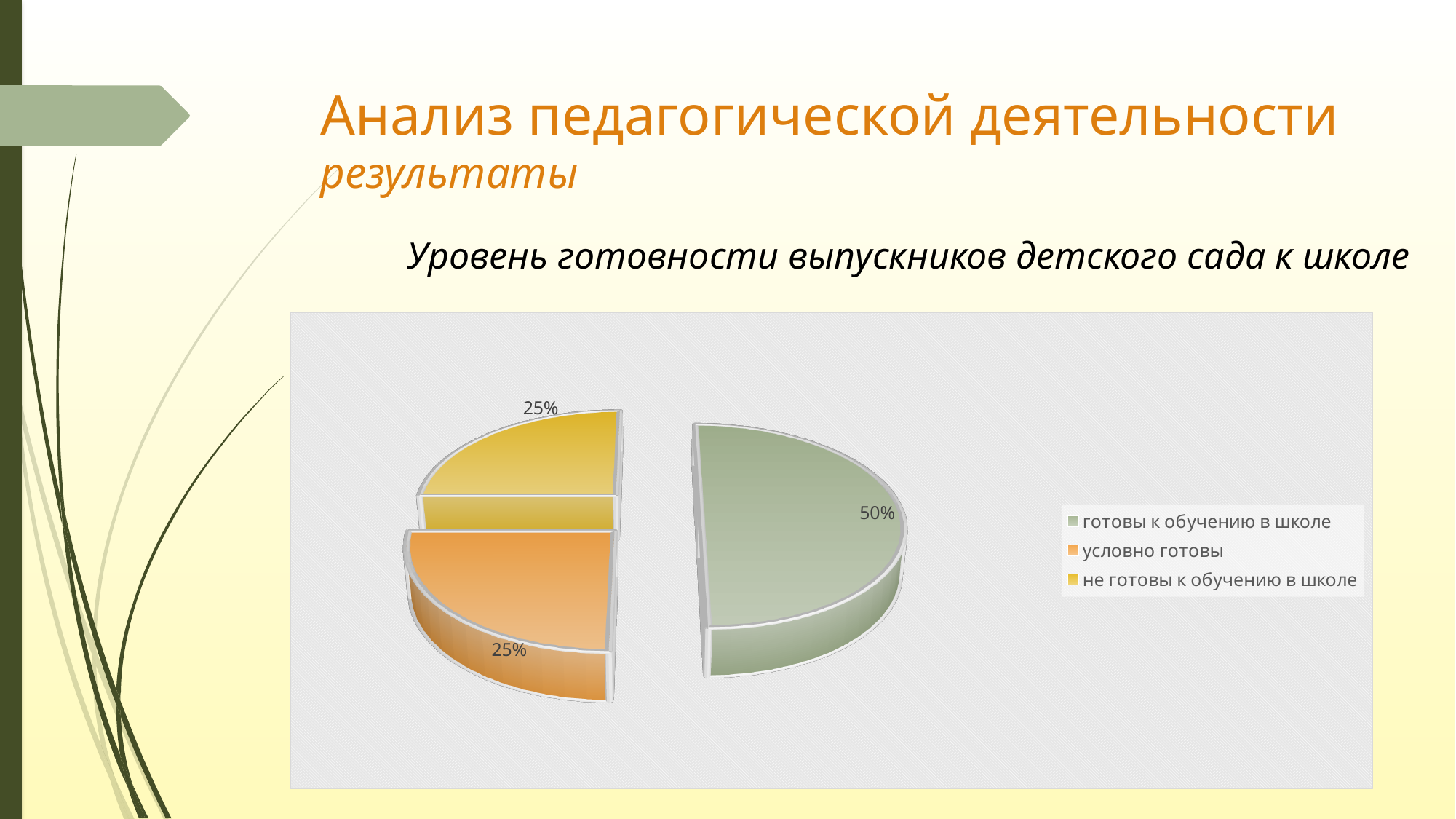
What kind of chart is shown on the slide? pie chart What is the value shown for "условно готовы"? 25% How many entries are listed in the chart legend? 3 What is the title written above the chart? Уровень готовности выпускников детского сада к школе What is the value shown for "не готовы к обучению в школе"? 25% What is the difference in percentage points between "готовы к обучению в школе" and "не готовы к обучению в школе"? 25 What share of the pie is labelled "готовы к обучению в школе"? 50% How many slices does the pie chart have? 3 Which category has the largest slice of the pie? готовы к обучению в школе Which colour represents "условно готовы" in the chart? orange Which is larger: the slice for "готовы к обучению в школе" or the slice for "условно готовы"? готовы к обучению в школе